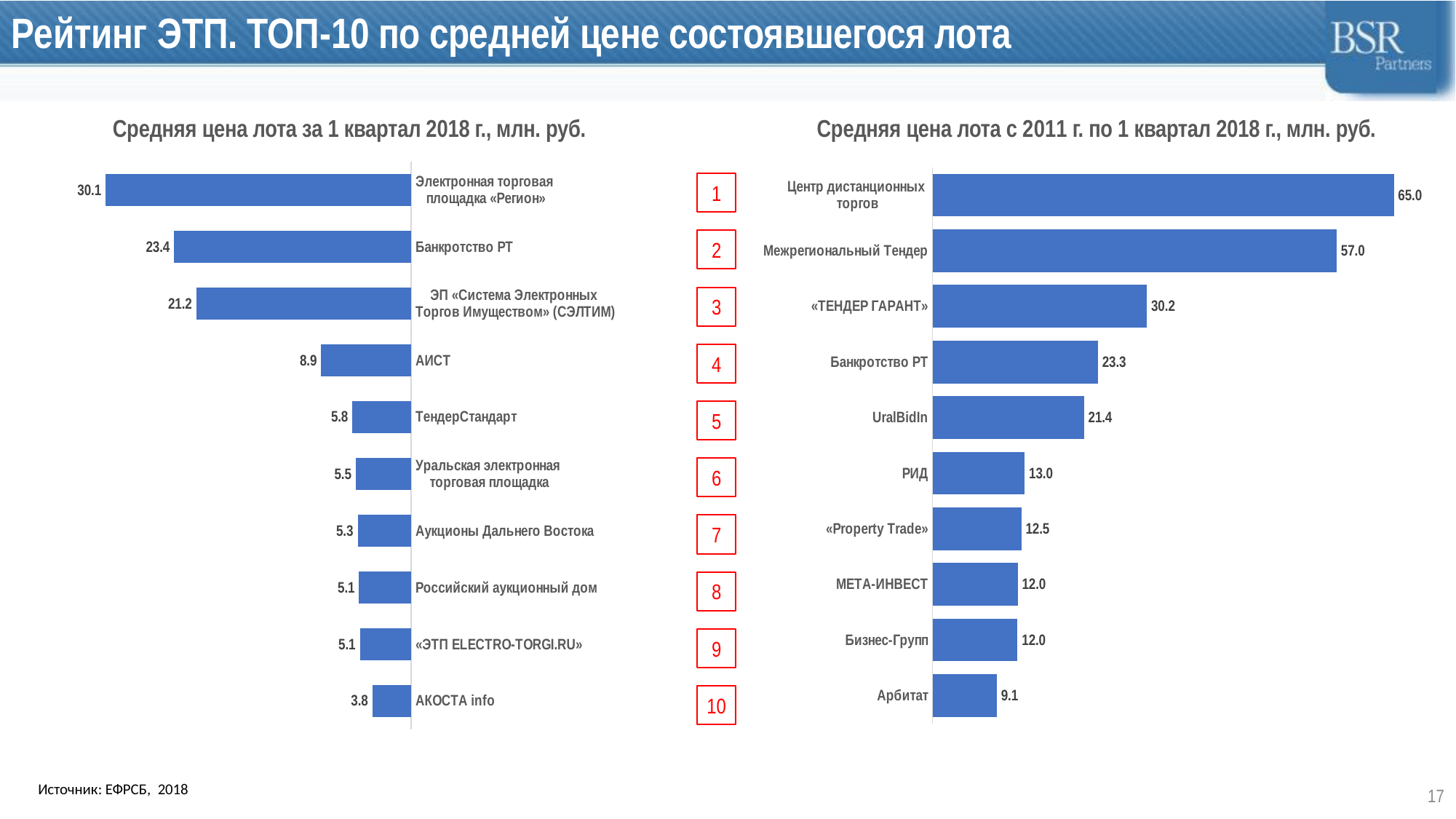
What type of chart is the left chart (Средняя цена лота за 1 квартал 2018 г.)? Bar chart In the left chart (Средняя цена лота за 1 квартал 2018 г.), what is the value for Банкротство РТ? 23.4 In the right chart (Средняя цена лота с 2011 г. по 1 квартал 2018 г.), which is larger: the value for «ТЕНДЕР ГАРАНТ» or the value for Банкротство РТ? «ТЕНДЕР ГАРАНТ» In the right chart (Средняя цена лота с 2011 г. по 1 квартал 2018 г.), what is the value for UralBidIn? 21.4 What is the title of the right chart? Средняя цена лота с 2011 г. по 1 квартал 2018 г., млн. руб. In the left chart (Средняя цена лота за 1 квартал 2018 г.), what is the difference between the values for Электронная торговая площадка «Регион» and АИСТ? 21.2 In the left chart (Средняя цена лота за 1 квартал 2018 г.), which category has the highest value? Электронная торговая площадка «Регион» In the right chart (Средняя цена лота с 2011 г. по 1 квартал 2018 г.), what is the value for Арбитат? 9.1 In the right chart (Средняя цена лота с 2011 г. по 1 квартал 2018 г.), which category has the highest value? Центр дистанционных торгов In the left chart (Средняя цена лота за 1 квартал 2018 г.), how many categories are shown? 10 In the right chart (Средняя цена лота с 2011 г. по 1 квартал 2018 г.), what is the difference between the values for Центр дистанционных торгов and Межрегиональный Тендер? 8.0 In the left chart (Средняя цена лота за 1 квартал 2018 г.), which category has the lowest value? АКОСТА info